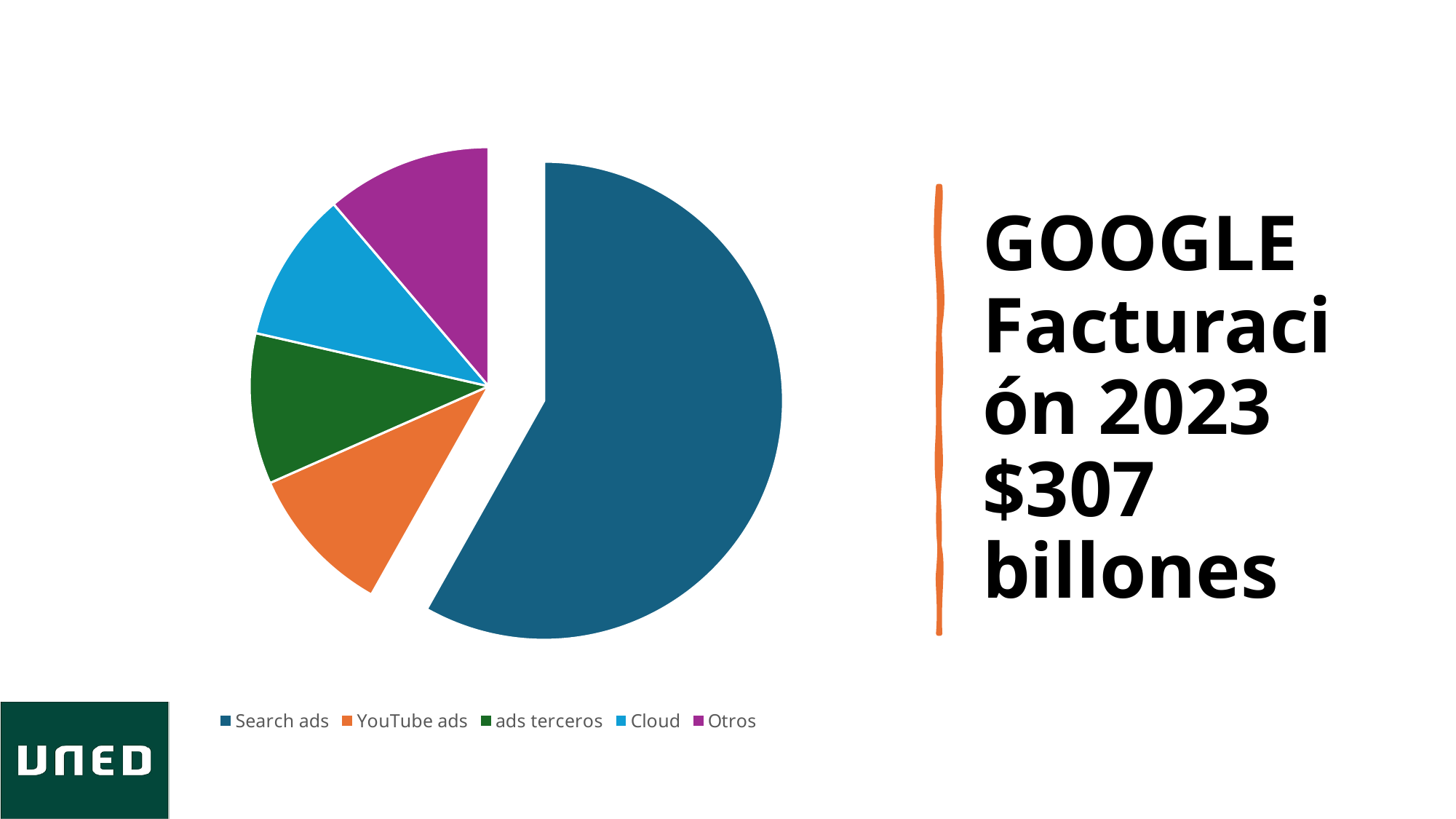
Which is larger, the slice for Search ads or the slice for Cloud? Search ads Which slice is pulled out (exploded) from the rest of the pie? Search ads What are the legend entries of the pie chart, in order? Search ads, YouTube ads, ads terceros, Cloud, Otros How many categories (slices) does the pie chart have? 5 Which is larger, the slice for Search ads or the slice for YouTube ads? Search ads Does the Search ads slice account for more or less than half of the pie? more Which category has the largest slice of the pie chart? Search ads What kind of chart is shown on the slide? Pie chart